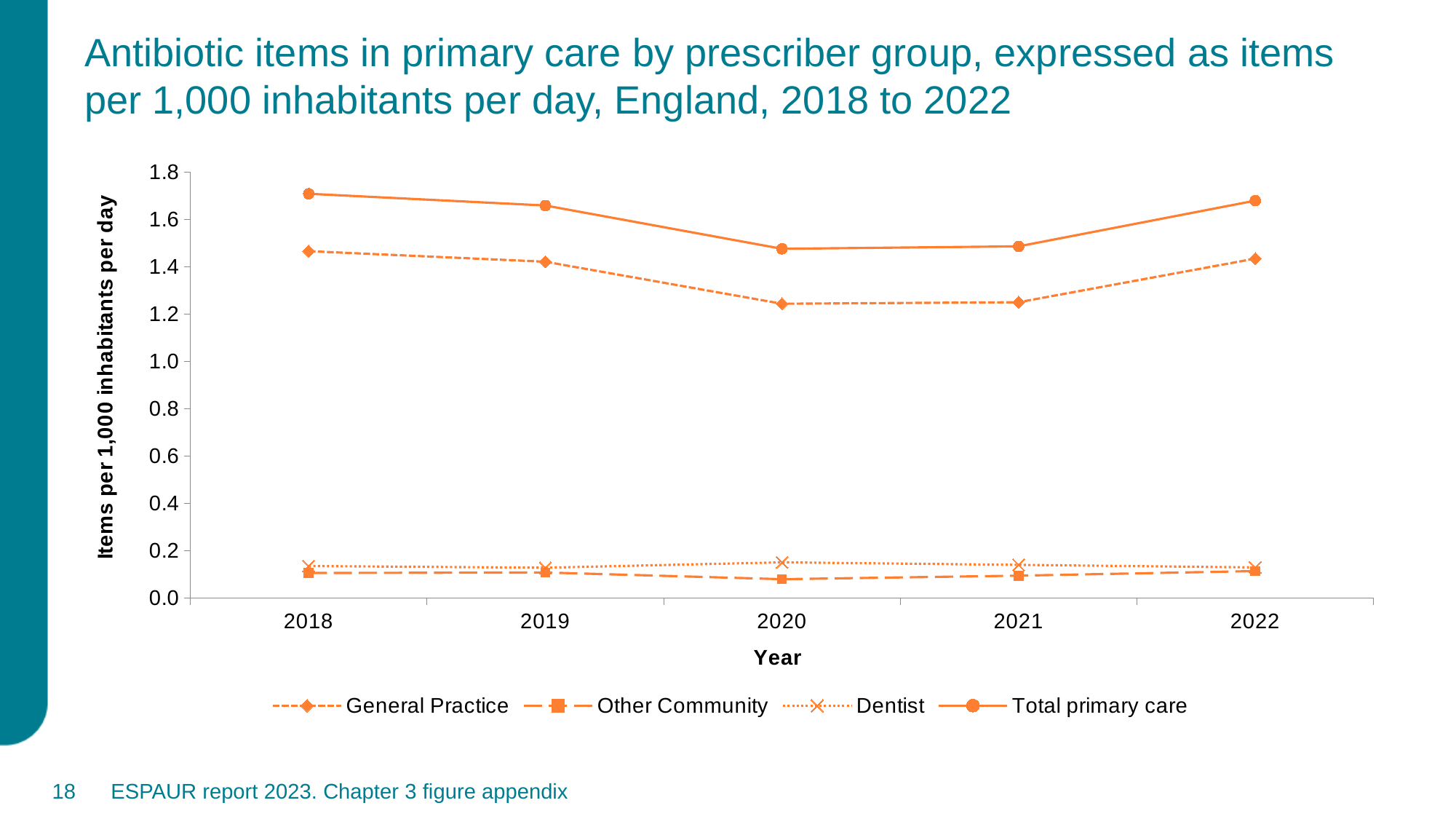
Is the value for Total primary care in 2018 greater or less than 1.6? greater Is the value for Dentist in 2020 greater or less than 0.2? less Which is larger in 2018, Total primary care or General Practice? Total primary care What kind of chart is shown on the slide? line chart Is the value for Total primary care in 2020 greater or less than 1.6? less How many series does the legend list? 4 How many years are plotted along the x axis? 5 Which is larger in 2020, Dentist or Other Community? Dentist Does the General Practice line rise or fall from 2021 to 2022? rise Does the Total primary care line rise or fall from 2018 to 2020? fall What is the label of the y axis? Items per 1,000 inhabitants per day